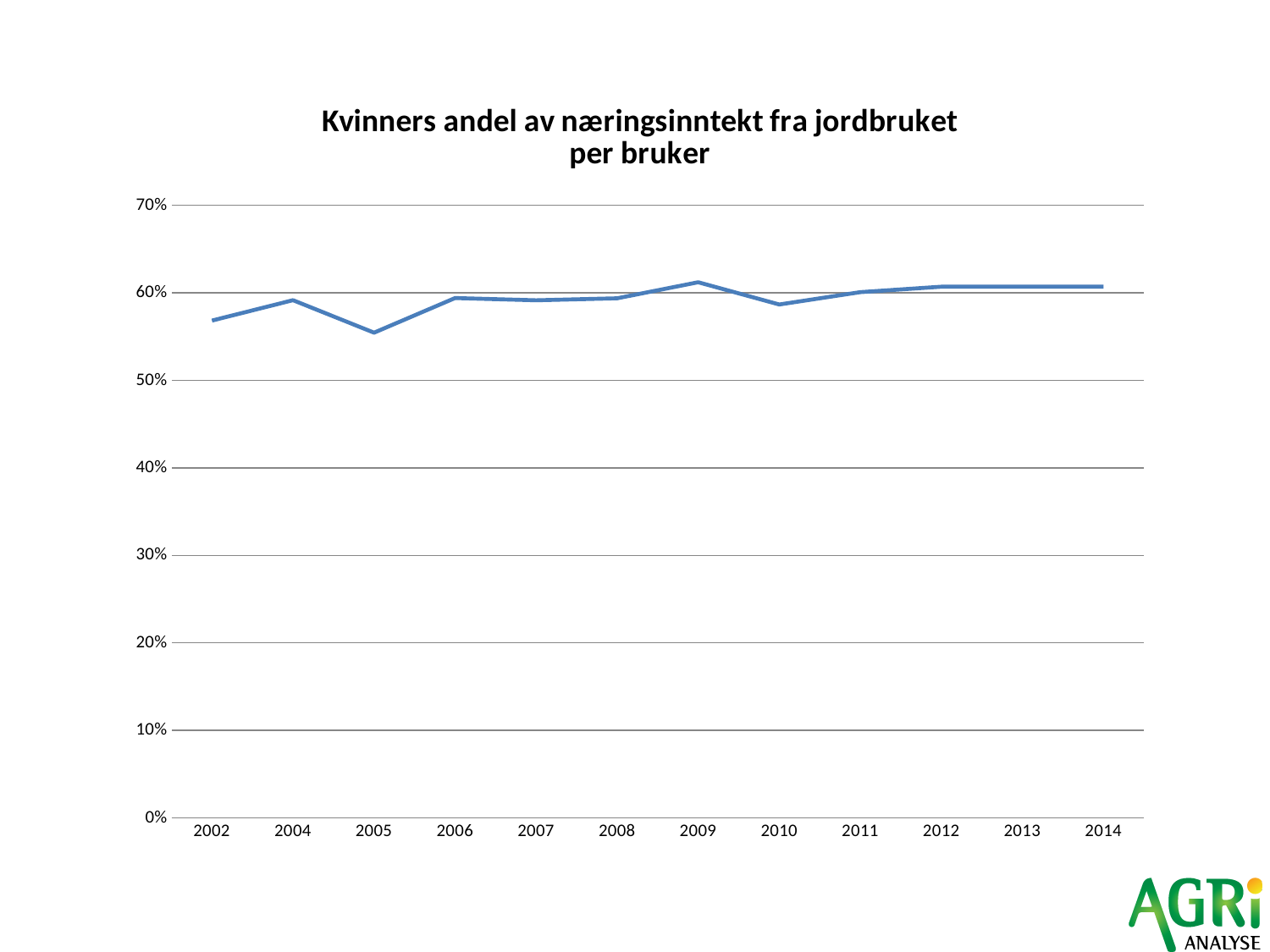
Is the value for 2002 greater or less than 50%? greater What is the title of the chart? Kvinners andel av næringsinntekt fra jordbruket per bruker What is the highest value shown on the y axis? 70% Which year has the lowest value? 2005 What kind of chart is shown on the slide? line chart Which year has the highest value? 2009 Which is larger, the value for 2005 or the value for 2009? 2009 Is the value for 2005 greater or less than 60%? less Is the value for 2009 greater or less than 60%? greater Does the value rise or fall from 2004 to 2005? fall How many years are plotted along the x axis? 12 Which is larger, the value for 2002 or the value for 2004? 2004